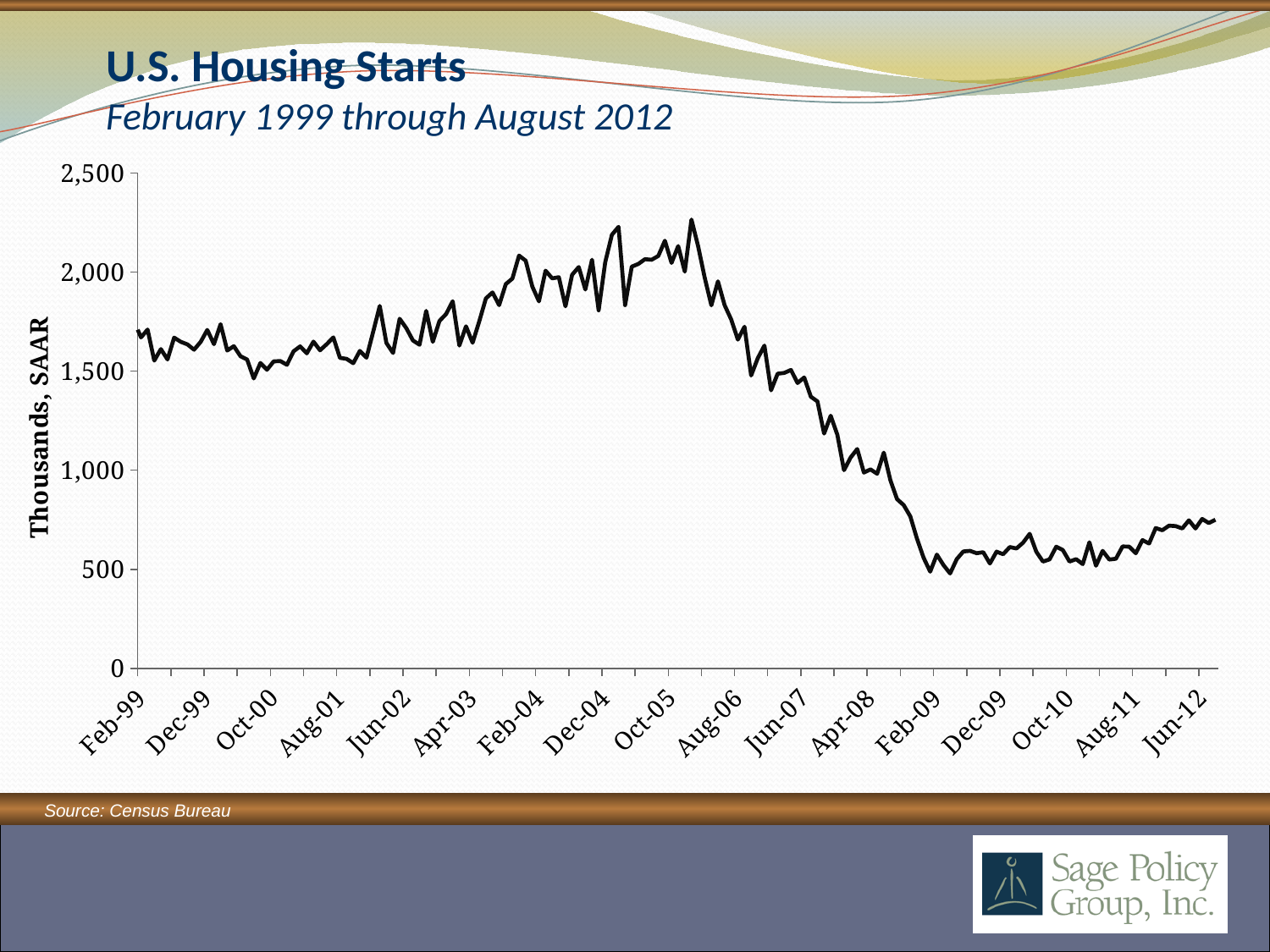
Is the value for Feb-09 greater or less than 1,000? less What is the title of the chart? U.S. Housing Starts What is the label on the vertical axis? Thousands, SAAR Do housing starts rise or fall between Feb-09 and Jun-12? rise Is the value for Jun-12 greater or less than 1,000? less Do housing starts rise or fall between Oct-05 and Feb-09? fall Which is larger, the value for Feb-99 or the value for Jun-12? Feb-99 Is the highest point on the line greater or less than 2,000? greater What kind of chart is shown on the slide? line chart How many date labels are shown along the x axis? 17